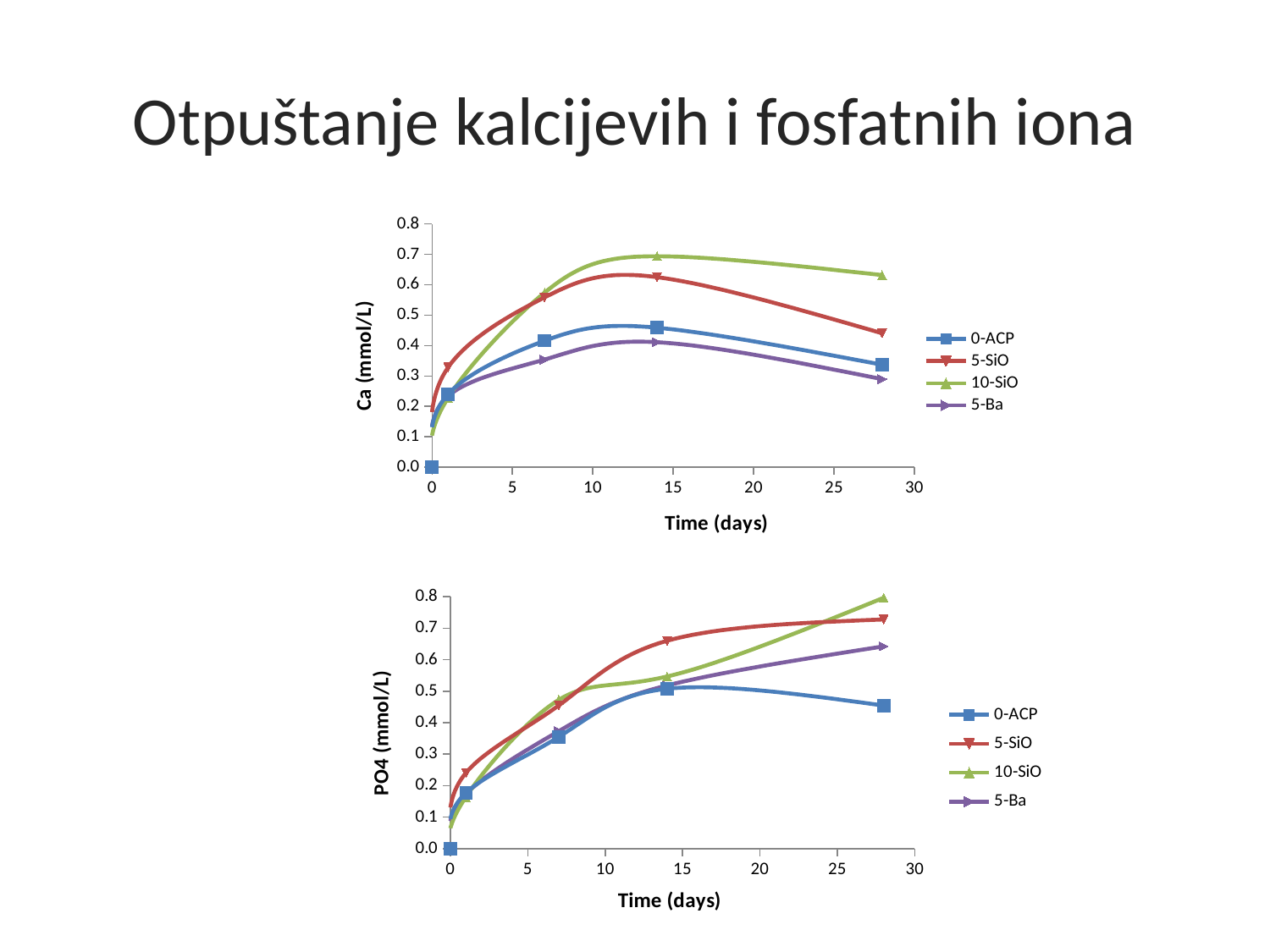
In the bottom chart (PO4 (mmol/L)), is the value for 5-SiO at 14 days greater or less than 0.6? greater In the top chart (Ca (mmol/L)), is the value for 10-SiO at 14 days greater or less than 0.6? greater In the top chart (Ca (mmol/L)), does the 5-SiO series rise or fall between 14 and 28 days? fall In the bottom chart (PO4 (mmol/L)), is the value for 0-ACP at 28 days greater or less than 0.5? less In the top chart (Ca (mmol/L)), which series has the highest value at 28 days? 10-SiO What is the x-axis title of the top chart? Time (days) What type of chart is the top chart (Ca (mmol/L))? line chart In the bottom chart (PO4 (mmol/L)), which series has the lowest value at 28 days? 0-ACP In the bottom chart (PO4 (mmol/L)), which series has the highest value at 28 days? 10-SiO How many series does the legend of the bottom chart (PO4 (mmol/L)) list? 4 In the bottom chart (PO4 (mmol/L)), which is larger at 28 days: 5-SiO or 5-Ba? 5-SiO